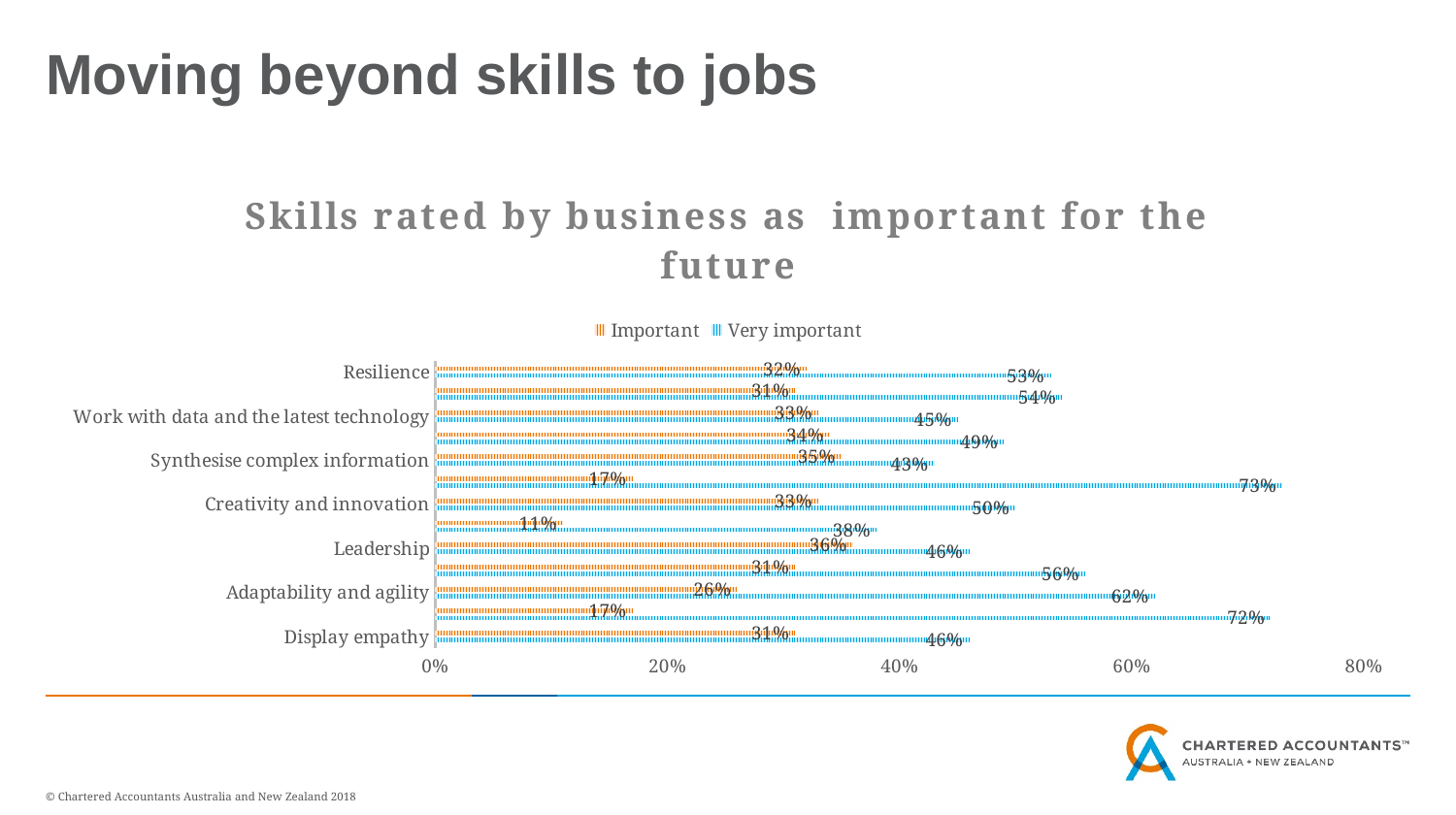
How many series does the legend list? 2 What is the title of the chart? Skills rated by business as important for the future What is the Very important value for Work with data and the latest technology? 45% For Resilience, what is the difference between the Very important and Important values? 21 percentage points What type of chart is shown on the slide? Bar chart What percentage rated Adaptability and agility as Very important? 62% For Creativity and innovation, how much higher is the Very important value than the Important value? 17 percentage points What is the Important value for Synthesise complex information? 35% Which has a higher Very important value: Adaptability and agility or Leadership? Adaptability and agility What is the Important value for Leadership? 36% What percentage of businesses rated Resilience as Very important? 53% What is the Important value for Display empathy? 31%